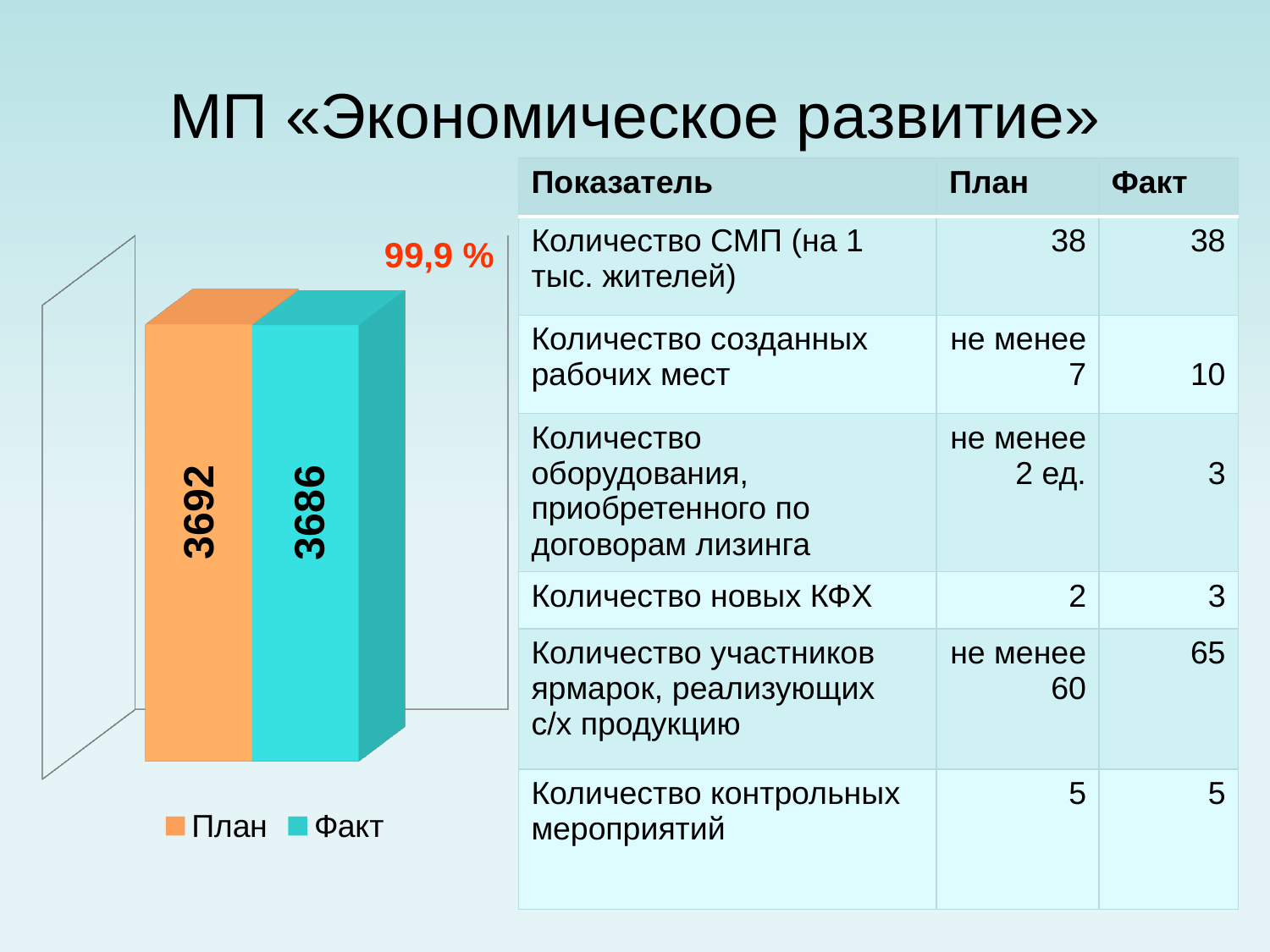
What is the value of the Факт bar in the chart? 3686 Which series has the higher value in the chart, План or Факт? План What percentage is printed above the chart? 99,9 % What kind of chart is shown on the slide? bar chart What colour is the Факт series in the chart? turquoise Which series has the lowest value in the chart? Факт What is the value of the План bar in the chart? 3692 How many bars are plotted in the chart? 2 What is the difference between the План and Факт values in the chart? 6 How many series does the chart legend list? 2